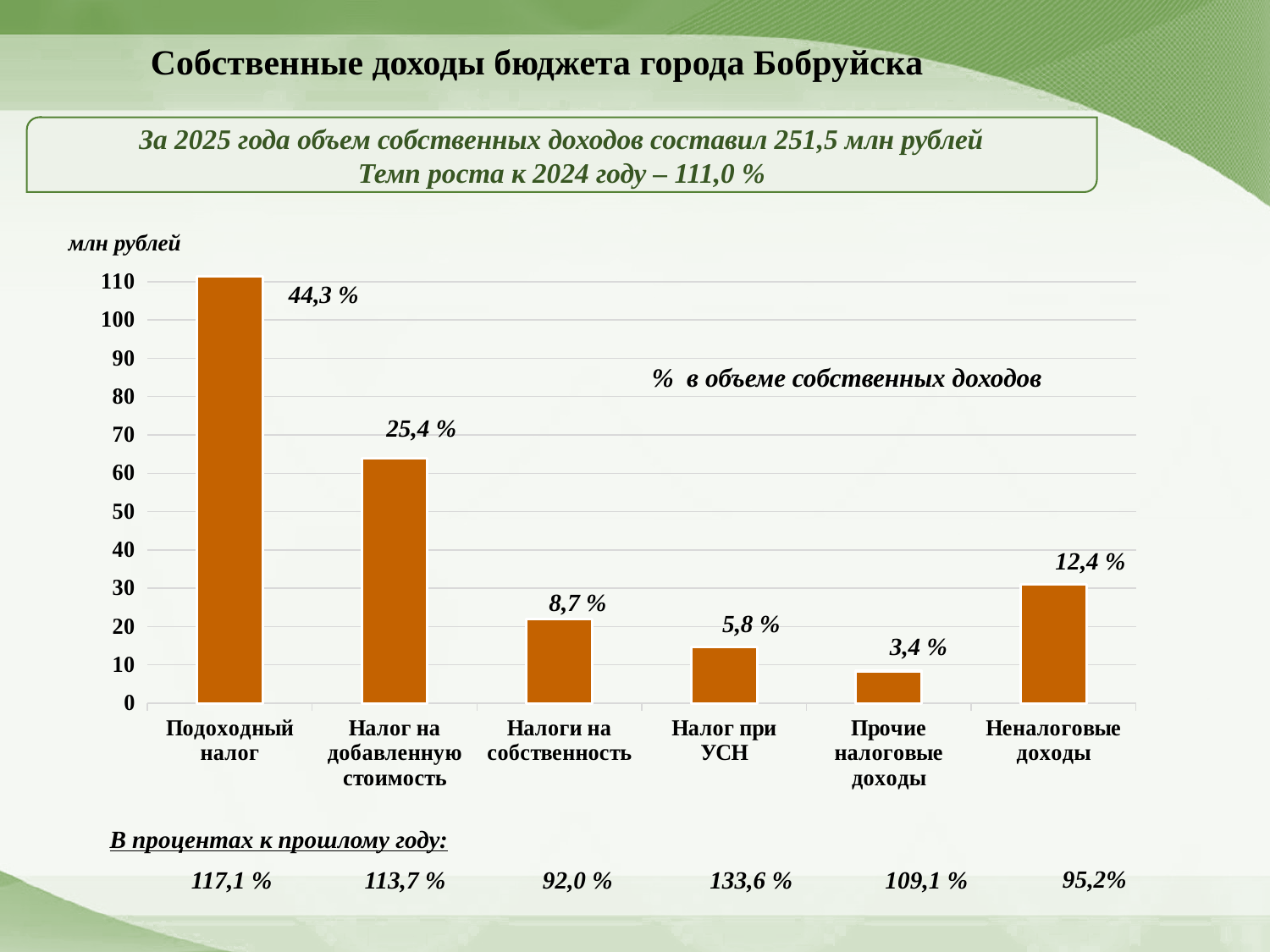
Is the value for Прочие налоговые доходы greater or less than 10 млн рублей? less What unit is shown above the y axis of the chart? млн рублей How many categories are shown on the x axis of the chart? 6 Which bar is taller: Неналоговые доходы or Налоги на собственность? Неналоговые доходы Which category has the lowest bar in the chart? Прочие налоговые доходы What share of own revenues is labelled for Неналоговые доходы? 12,4 % What share of own revenues (% в объеме собственных доходов) is labelled for Подоходный налог? 44,3 % What share of own revenues is labelled for Налог на добавленную стоимость? 25,4 % Which category has the highest bar in the chart? Подоходный налог What is the difference between the share labels for Подоходный налог (44,3 %) and Налог на добавленную стоимость (25,4 %)? 18,9 % What kind of chart is shown on the slide? bar chart Is the value for Подоходный налог greater or less than 100 млн рублей? greater